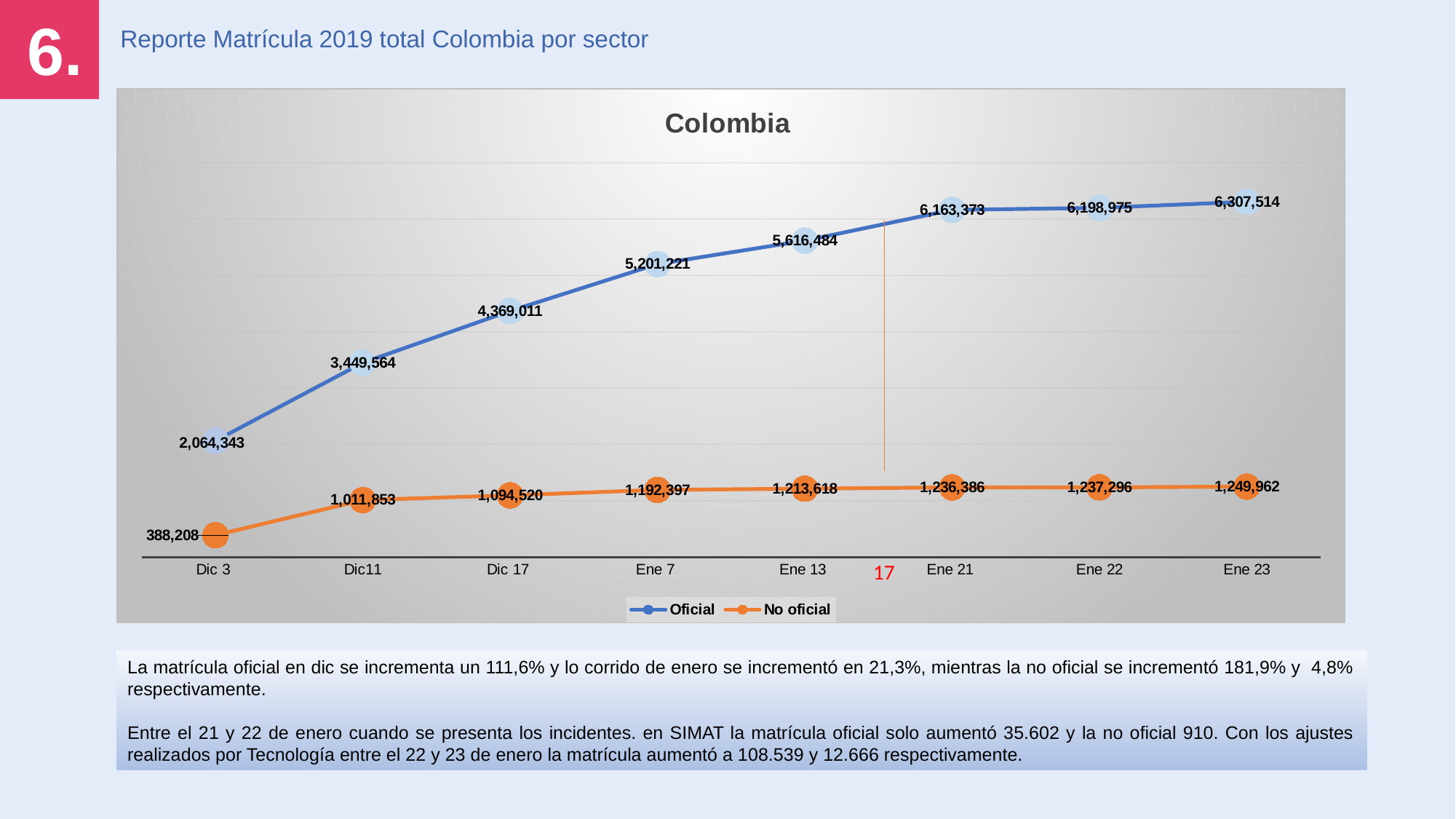
What is the title of the chart? Colombia Does the Oficial series rise or fall from Dic 3 to Ene 23? Rise On which date is the Oficial value highest? Ene 23 What type of chart is shown on the slide? Line chart By how much did the Oficial value increase from Ene 21 to Ene 22? 35,602 How many dates are plotted along the x axis? 8 On which date is the No oficial value lowest? Dic 3 What is the No oficial value on Dic 3? 388,208 What is the Oficial value on Dic 17? 4,369,011 How many series does the legend list? 2 By how much did the No oficial value increase from Ene 22 to Ene 23? 12,666 What is the Oficial value on Ene 23? 6,307,514